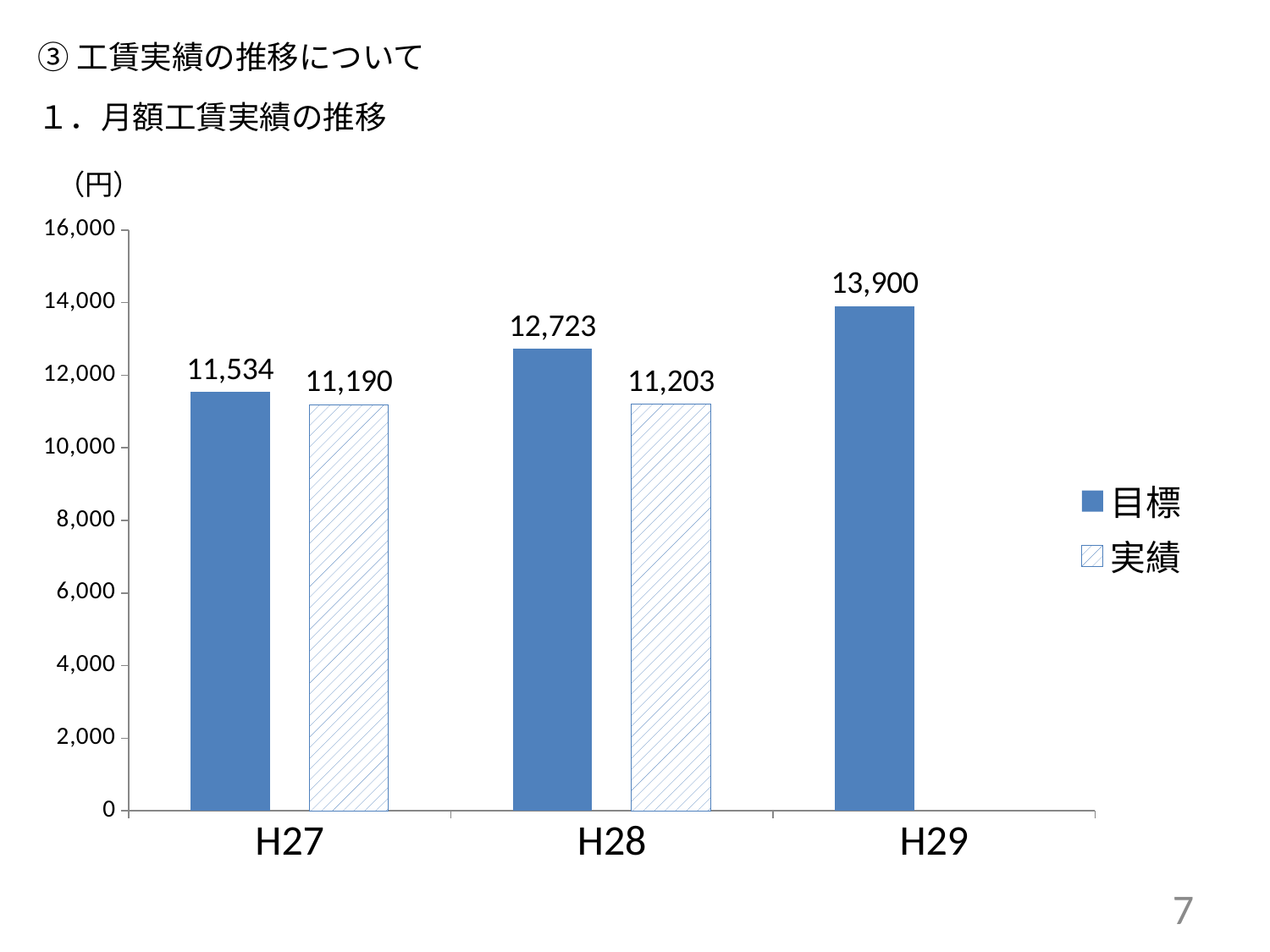
What is the difference between the 目標 and 実績 values for H28? 1,520 Do the 目標 values rise or fall from H27 to H29? rise What kind of chart is shown on the slide? bar chart What is the difference between the 目標 values for H29 and H27? 2,366 Which year has the highest 目標 value? H29 What is the 目標 value for H29? 13,900 What is the 実績 value for H28? 11,203 Which is larger for H27, the 目標 value or the 実績 value? 目標 How many years are shown on the x axis? 3 How many series does the legend list? 2 What is the 目標 value for H27? 11,534 Which year has the lowest 目標 value? H27